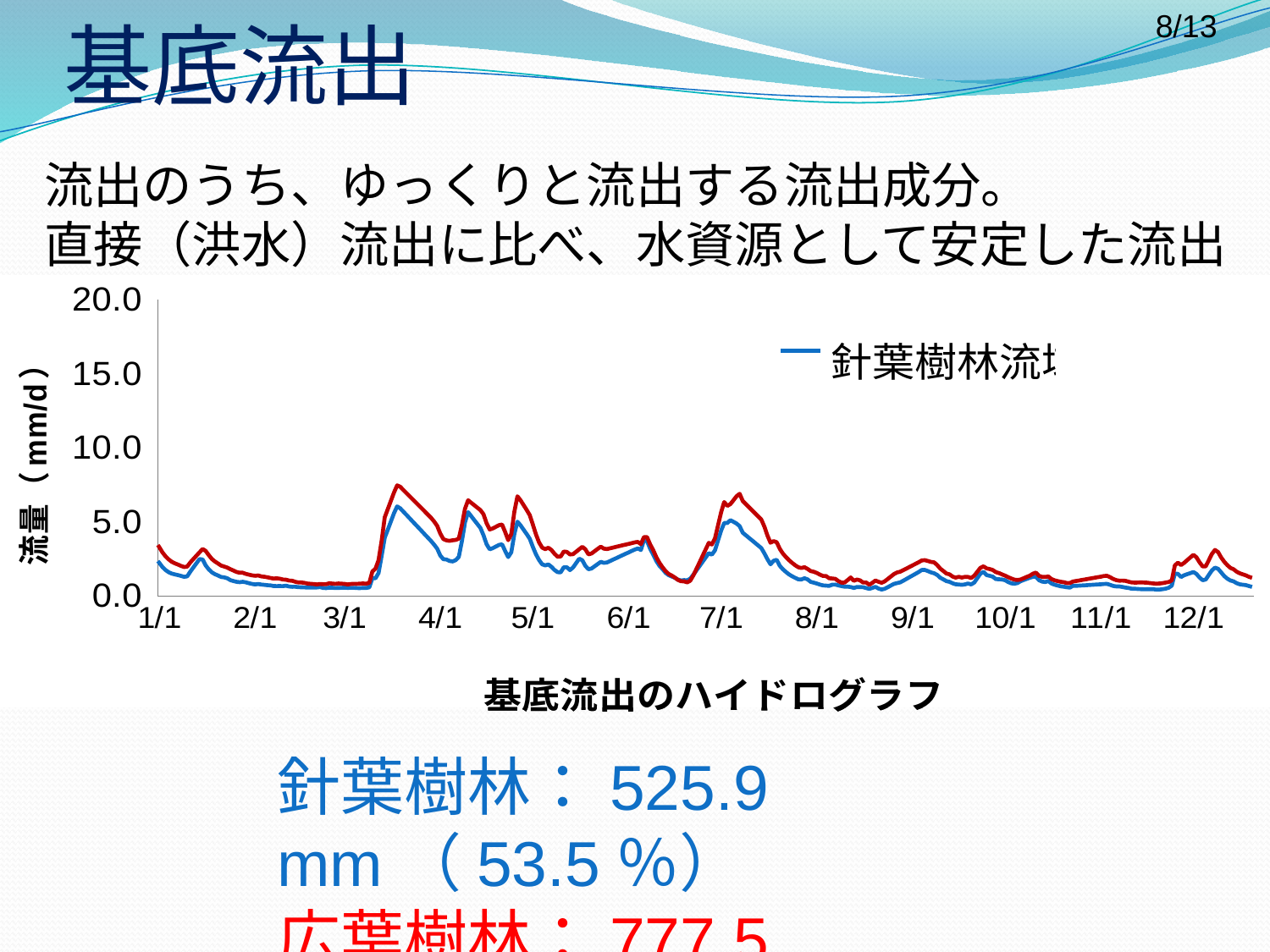
What is the label of the vertical axis of the chart? 流量（mm/d） Do the values of both lines rise or fall between the peak just after 7/1 and 8/1? fall At the peak between 3/1 and 4/1, which line is higher, the red line or the blue line? the red line How many month labels are shown along the horizontal axis? 12 Is the peak value of the red line between 3/1 and 4/1 greater or less than 5.0? greater Is the peak value of the red line between 3/1 and 4/1 greater or less than 10.0? less Is the value of the red line at 11/1 greater or less than 5.0? less What is the highest tick value shown on the vertical axis? 20.0 What kind of chart is shown on the slide? line chart What is the title printed below the chart? 基底流出のハイドログラフ